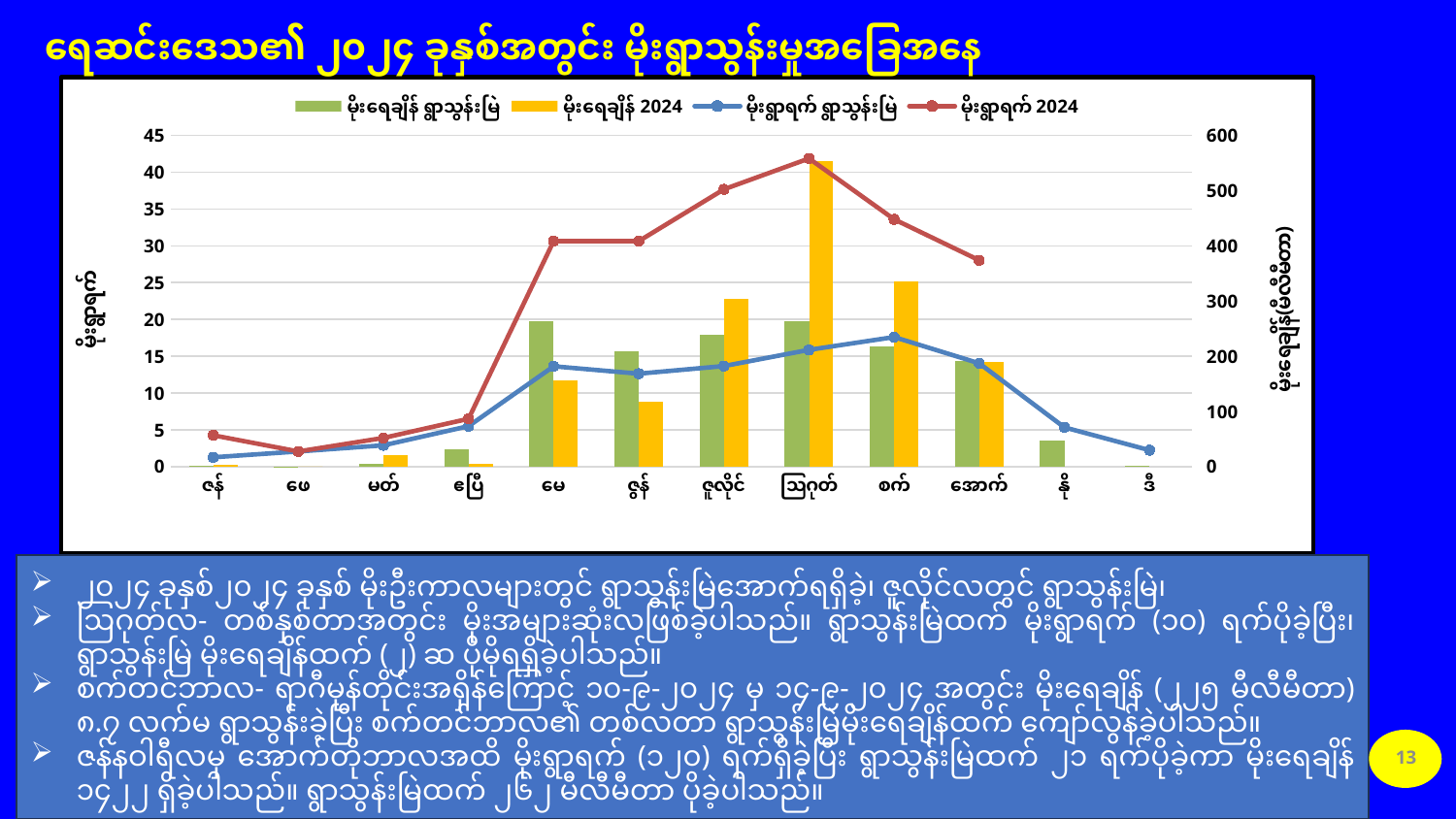
Is the yellow bar (မိုးရေချိန် 2024) for သြဂုတ် greater or less than 40 on the left axis? greater How many series does the chart legend list? 4 In မေ, which bar is taller: the green bar (မိုးရေချိန် ရွာသွန်းမြဲ) or the yellow bar (မိုးရေချိန် 2024)? Green bar (မိုးရေချိန် ရွာသွန်းမြဲ) How many categories (months) are shown on the x axis of the chart? 12 Does the red line (မိုးရွာရက် 2024) rise or fall from သြဂုတ် to အောက်? Fall Is the yellow bar (မိုးရေချိန် 2024) for စက် greater or less than 20 on the left axis? greater What is the title of the slide containing the chart? ရေဆင်းဒေသ၏ ၂၀၂၄ ခုနှစ်အတွင်း မိုးရွာသွန်းမှုအခြေအနေ What kind of chart is shown on the slide? Combination bar and line chart Is the red line (မိုးရွာရက် 2024) value for အောက် greater or less than 400 on the right axis? less Which month has the highest yellow bar (မိုးရေချိန် 2024)? သြဂုတ် In သြဂုတ်, which bar is taller: the green bar (မိုးရေချိန် ရွာသွန်းမြဲ) or the yellow bar (မိုးရေချိန် 2024)? Yellow bar (မိုးရေချိန် 2024)